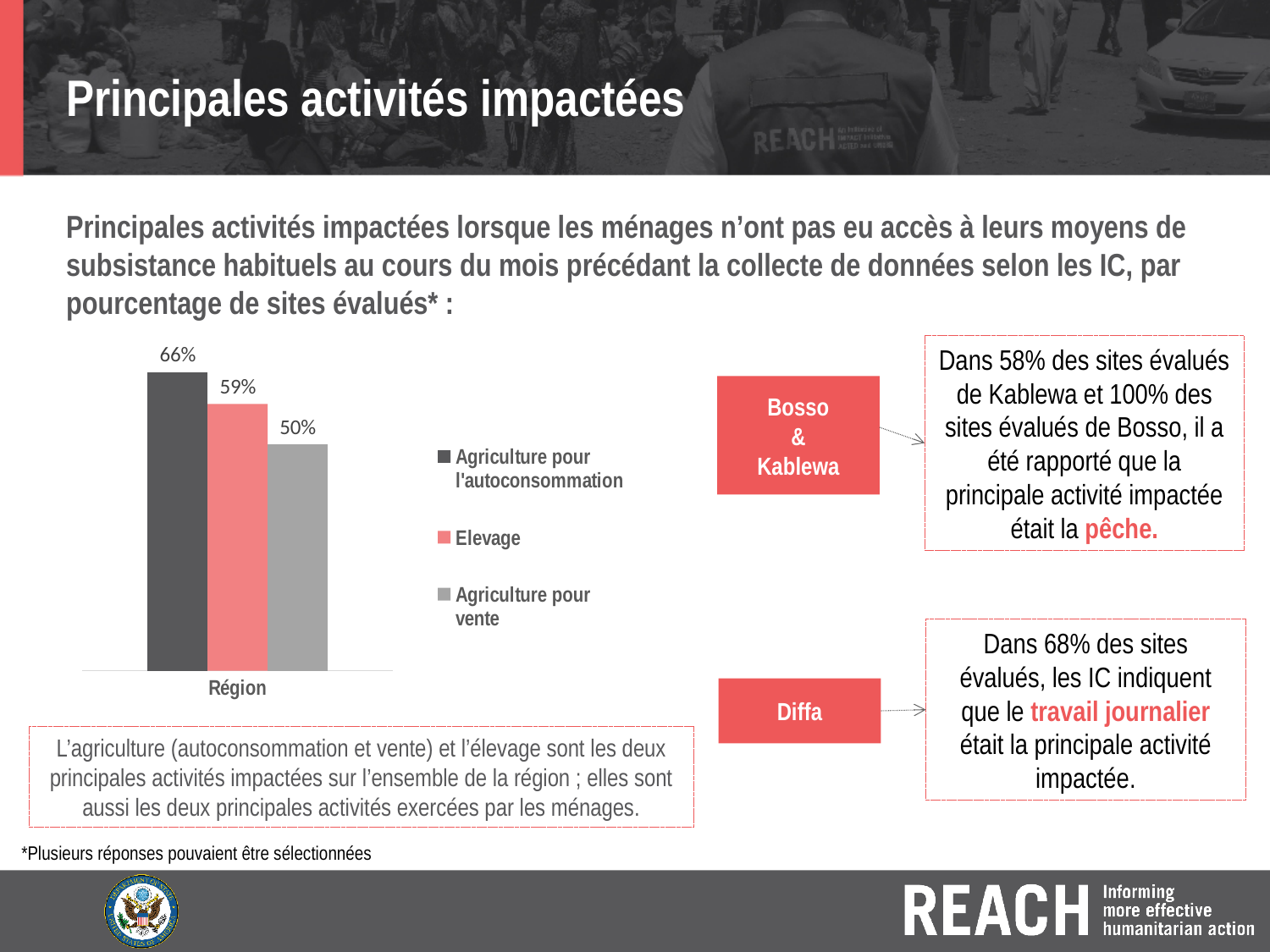
What is the difference between the values for Agriculture pour l'autoconsommation and Agriculture pour vente? 16% What is the difference between the values for Elevage and Agriculture pour vente? 9% Which series has the highest value in the chart? Agriculture pour l'autoconsommation What is the value for Elevage in the Région category? 59% Which series has the lowest value in the chart? Agriculture pour vente What is the label of the category on the x axis of the chart? Région How many series does the legend list? 3 What kind of chart is shown on the slide? Bar chart What colour is the bar for Elevage in the chart? Red What is the value for Agriculture pour l'autoconsommation in the Région category? 66% What is the value for Agriculture pour vente in the Région category? 50% Which is larger, the value for Elevage or the value for Agriculture pour vente? Elevage